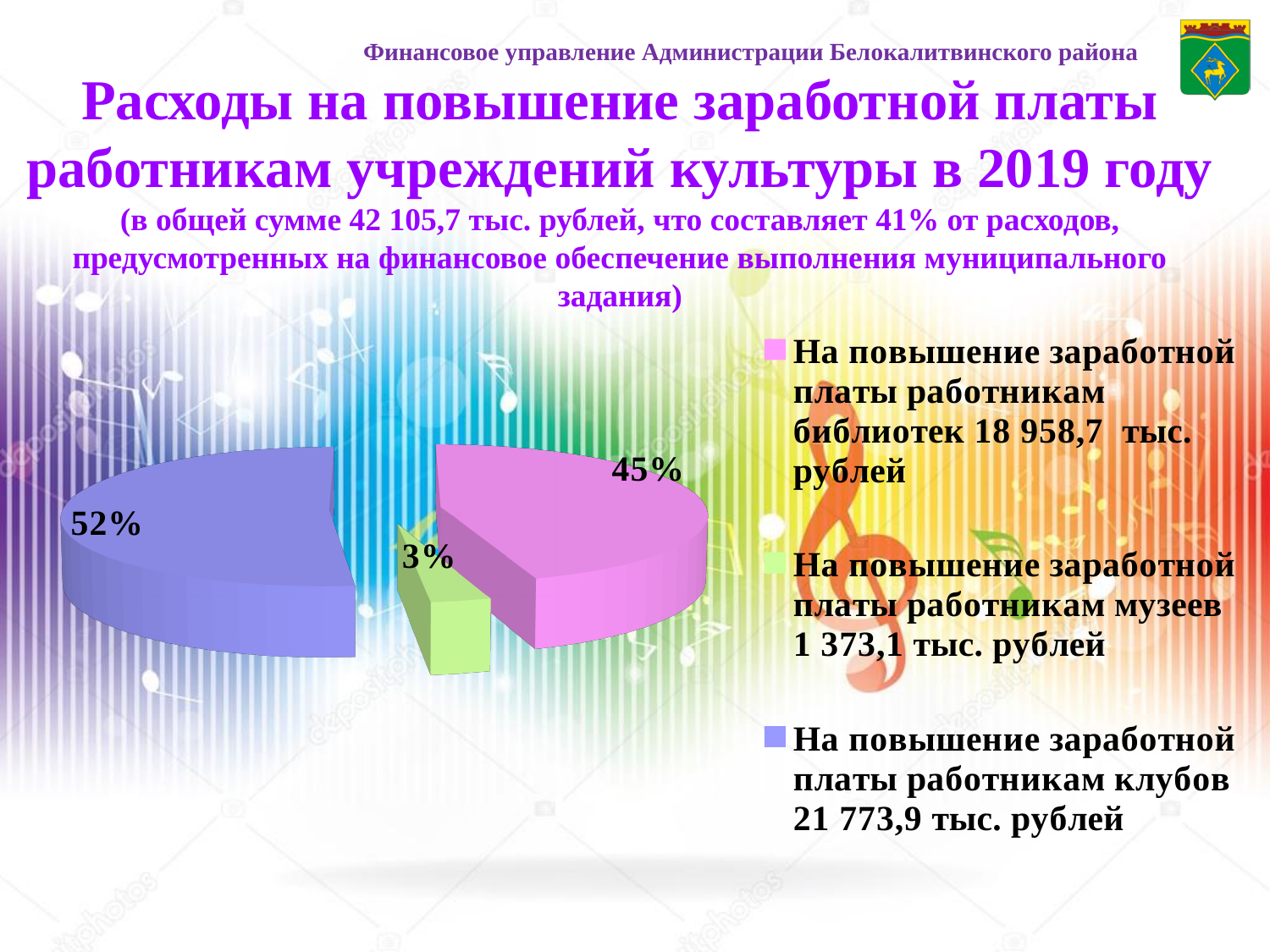
Какую долю диаграммы занимает сектор «На повышение заработной платы работникам музеев»? 3% Какой тип диаграммы представлен на слайде? Круговая диаграмма Каким цветом на диаграмме обозначен сектор «На повышение заработной платы работникам музеев»? Зелёным Какую долю диаграммы занимает сектор «На повышение заработной платы работникам клубов»? 52% Сколько элементов перечислено в легенде диаграммы? 3 На сколько процентных пунктов доля клубов больше доли библиотек? 7 Сколько секторов (категорий) показано на круговой диаграмме? 3 Какую долю диаграммы занимает сектор «На повышение заработной платы работникам библиотек»? 45% Какая категория имеет наименьшую долю на диаграмме? На повышение заработной платы работникам музеев Какая категория имеет наибольшую долю на диаграмме? На повышение заработной платы работникам клубов Какая сумма указана в легенде для повышения заработной платы работникам библиотек? 18 958,7 тыс. рублей Какая сумма указана в легенде для повышения заработной платы работникам музеев? 1 373,1 тыс. рублей